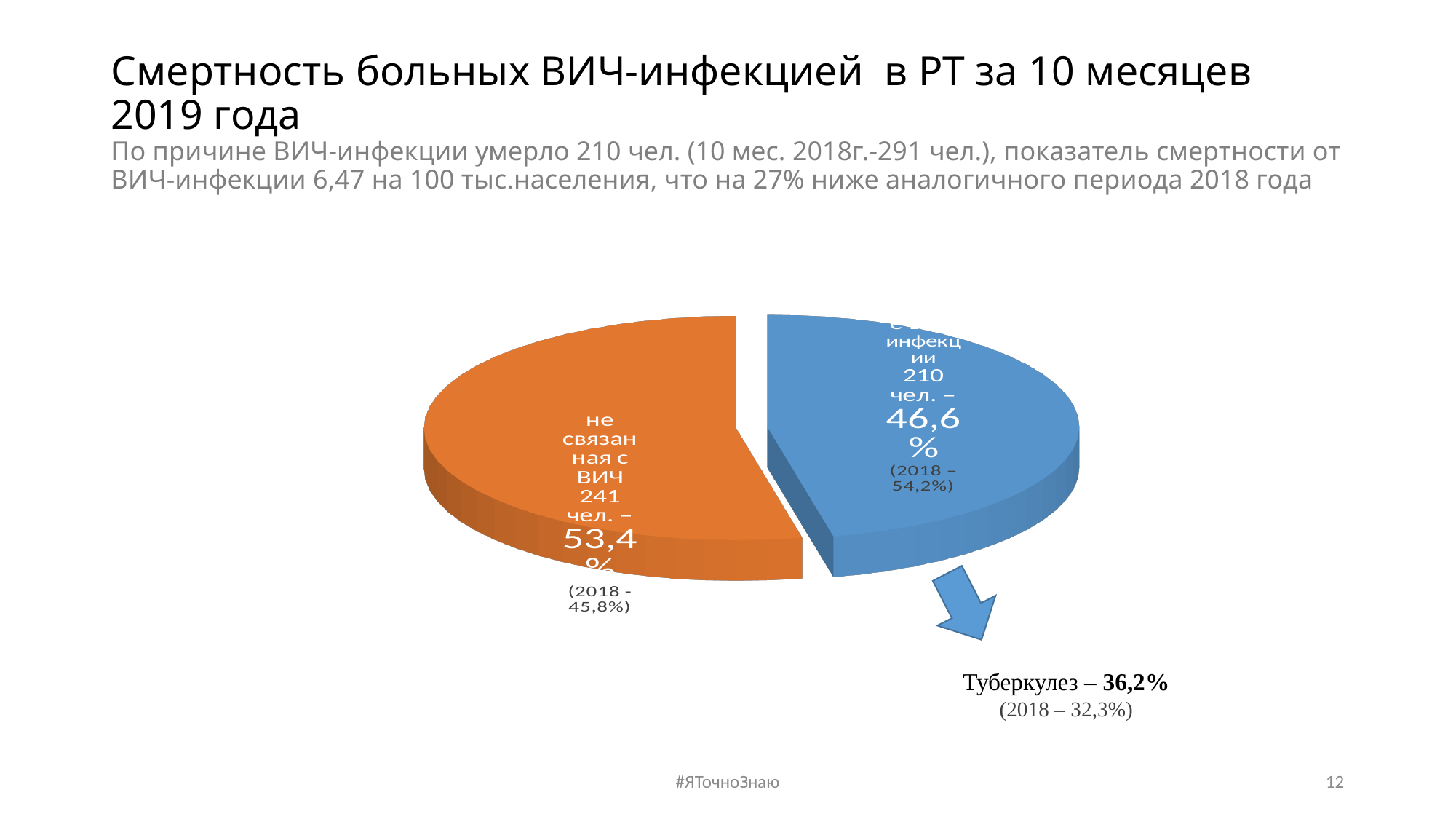
How many people (чел.) are shown for the blue slice of the pie? 210 чел. Which is larger: the number of people in the slice 'не связанная с ВИЧ' or in the blue slice (210 чел.)? не связанная с ВИЧ What share of the pie does the slice 'не связанная с ВИЧ' take? 53,4% What share of the pie does the blue slice (deaths from HIV infection, 210 чел.) take? 46,6% Which slice of the pie is larger? не связанная с ВИЧ What is the difference in people between the slice 'не связанная с ВИЧ' (241 чел.) and the blue slice (210 чел.)? 31 How many people (чел.) are shown for the slice 'не связанная с ВИЧ'? 241 чел. What colour is the slice labelled 'не связанная с ВИЧ'? orange What 2018 share is given in brackets for the slice 'не связанная с ВИЧ'? 45,8% What kind of chart is shown on the slide? pie chart What 2018 share is given in brackets for the blue slice (210 чел.)? 54,2% How many slices does the pie chart have? 2